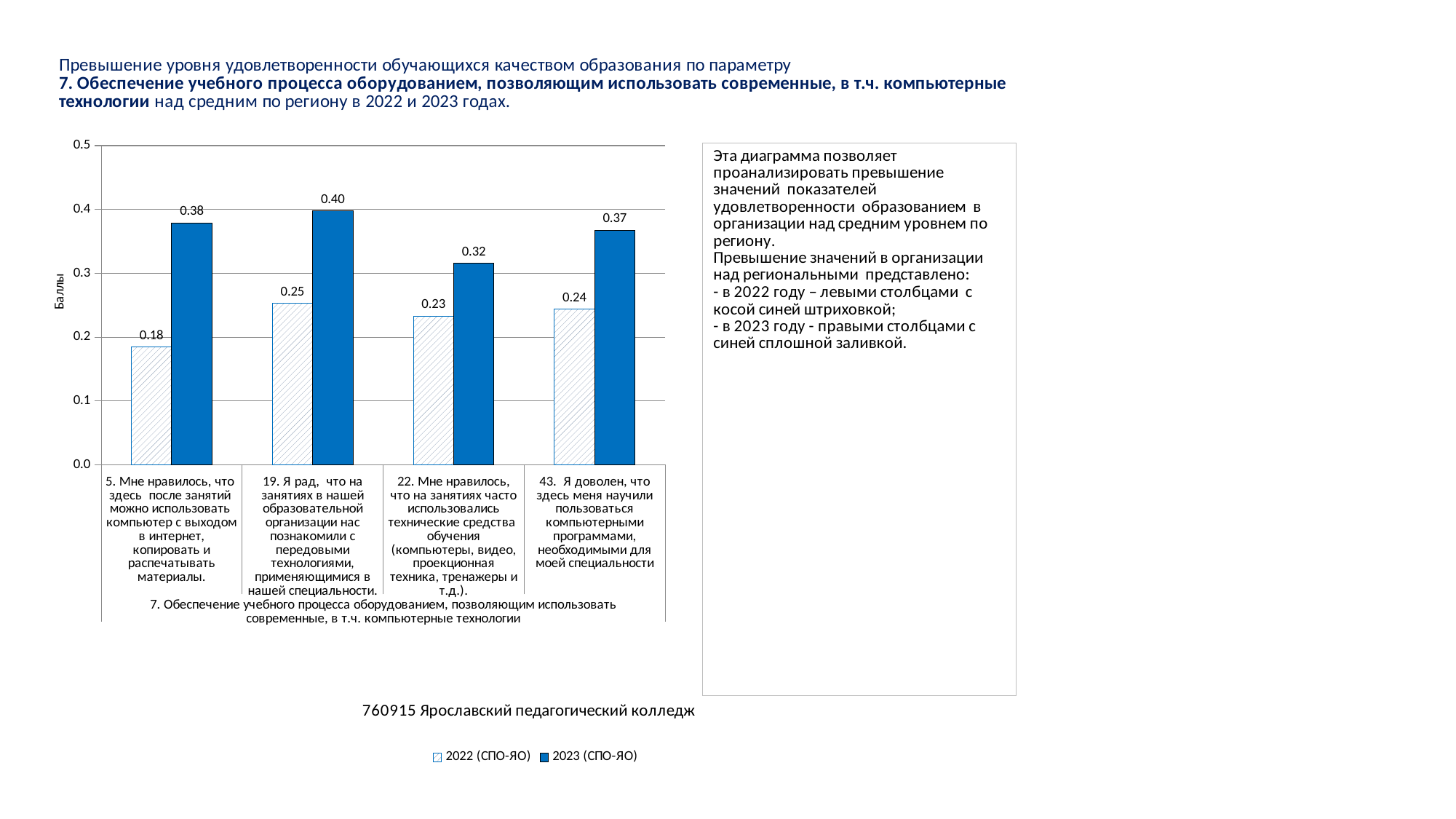
How many statements (categories) are shown on the x axis of the chart? 4 What is the 2023 (СПО-ЯО) value for statement 22 ("Мне нравилось, что на занятиях часто использовались технические средства обучения...")? 0.32 What is the difference between the 2023 and 2022 values for statement 5? 0.20 Which statement has the lowest 2022 (СПО-ЯО) value? 5. Мне нравилось, что здесь после занятий можно использовать компьютер с выходом в интернет, копировать и распечатывать материалы. What is the label of the vertical axis of the chart? Баллы What is the 2022 (СПО-ЯО) value for statement 5 ("Мне нравилось, что здесь после занятий можно использовать компьютер с выходом в интернет...")? 0.18 What is the 2023 (СПО-ЯО) value for statement 19 ("Я рад, что на занятиях в нашей образовательной организации нас познакомили с передовыми технологиями...")? 0.40 What kind of chart is shown on the slide? Bar chart What is the 2022 (СПО-ЯО) value for statement 43 ("Я доволен, что здесь меня научили пользоваться компьютерными программами...")? 0.24 For statement 43, which is larger: the 2022 (СПО-ЯО) value or the 2023 (СПО-ЯО) value? 2023 (СПО-ЯО) Which statement has the highest 2023 (СПО-ЯО) value? 19. Я рад, что на занятиях в нашей образовательной организации нас познакомили с передовыми технологиями, применяющимися в нашей специальности. How many series does the chart legend list? 2